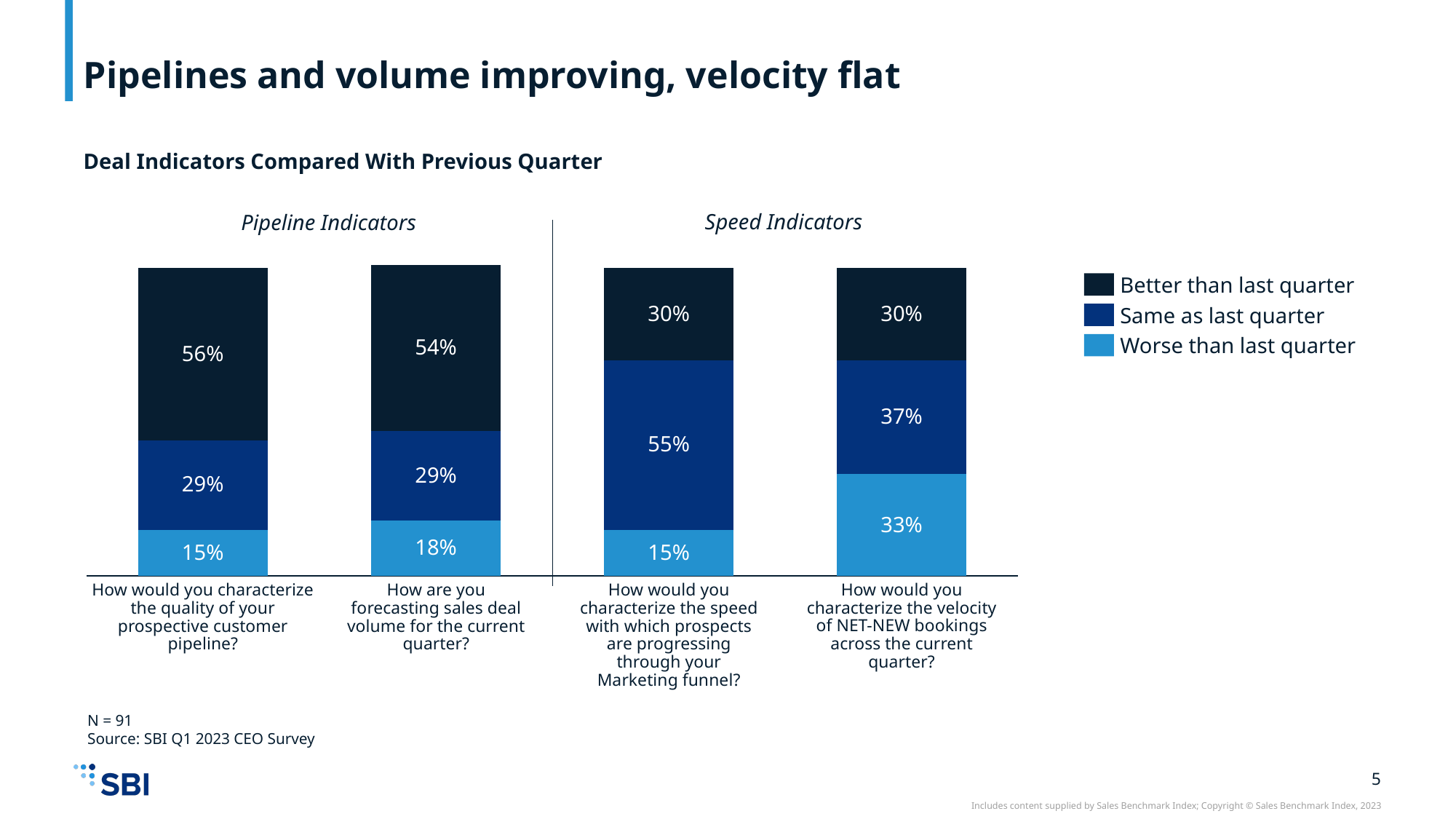
Which question has the highest share of 'Better than last quarter' responses? How would you characterize the quality of your prospective customer pipeline? How many survey questions (bars) are shown in the chart? 4 How many series does the legend list? 3 What percentage of respondents said the quality of their prospective customer pipeline is better than last quarter? 56% What is the total of the three segments in the bar for the quality of the prospective customer pipeline? 100% What share of respondents are forecasting sales deal volume for the current quarter as worse than last quarter? 18% How many percentage points higher is the 'Better than last quarter' share for pipeline quality than for the speed of prospects through the Marketing funnel? 26 percentage points What percentage characterized the velocity of NET-NEW bookings across the current quarter as worse than last quarter? 33% Which has a larger 'Same as last quarter' share: the speed of prospects through the Marketing funnel or the velocity of NET-NEW bookings? Speed of prospects through the Marketing funnel What percentage characterized the speed with which prospects are progressing through the Marketing funnel as the same as last quarter? 55% What type of chart is shown on the slide? Stacked bar chart Which question has the highest share of 'Worse than last quarter' responses? How would you characterize the velocity of NET-NEW bookings across the current quarter?